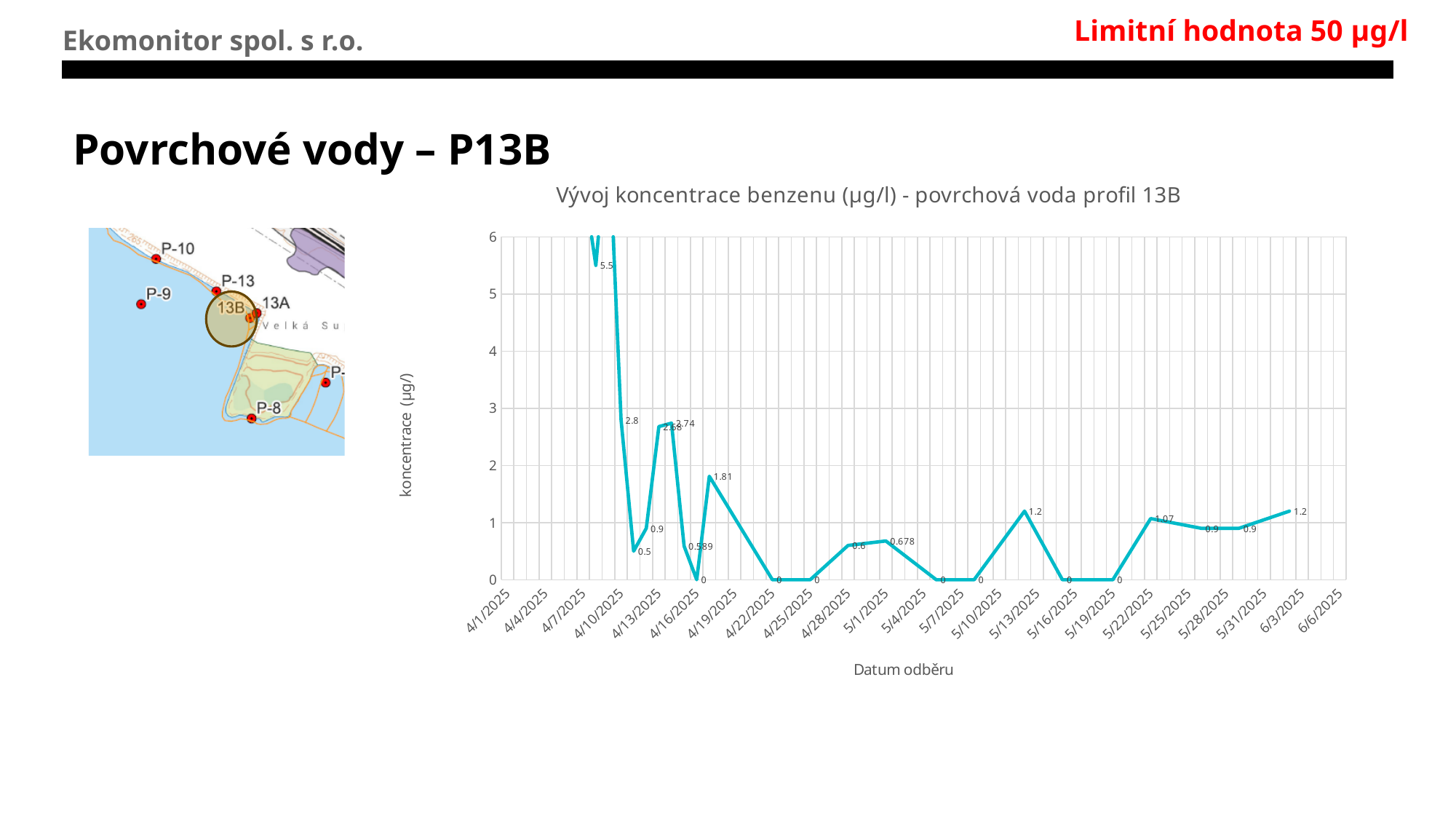
What is the label of the x axis of the chart? Datum odběru How many plotted points are labeled 0? 7 Is the value of the last plotted point greater or less than 2? less Is the highest value on the chart greater or less than 5? greater What is the title of the chart? Vývoj koncentrace benzenu (µg/l) - povrchová voda profil 13B Which is larger, the point labeled 2.74 or the point labeled 1.81? 2.74 What is the highest labeled value on the chart? 5.5 What is the lowest labeled value on the chart? 0 What is the value of the last plotted point on the chart? 1.2 What kind of chart is shown on the slide? line chart Overall, do the values rise or fall from the first point to the last point along the x axis? fall What is the difference between the highest labeled value (5.5) and the next labeled value (2.8)? 2.7